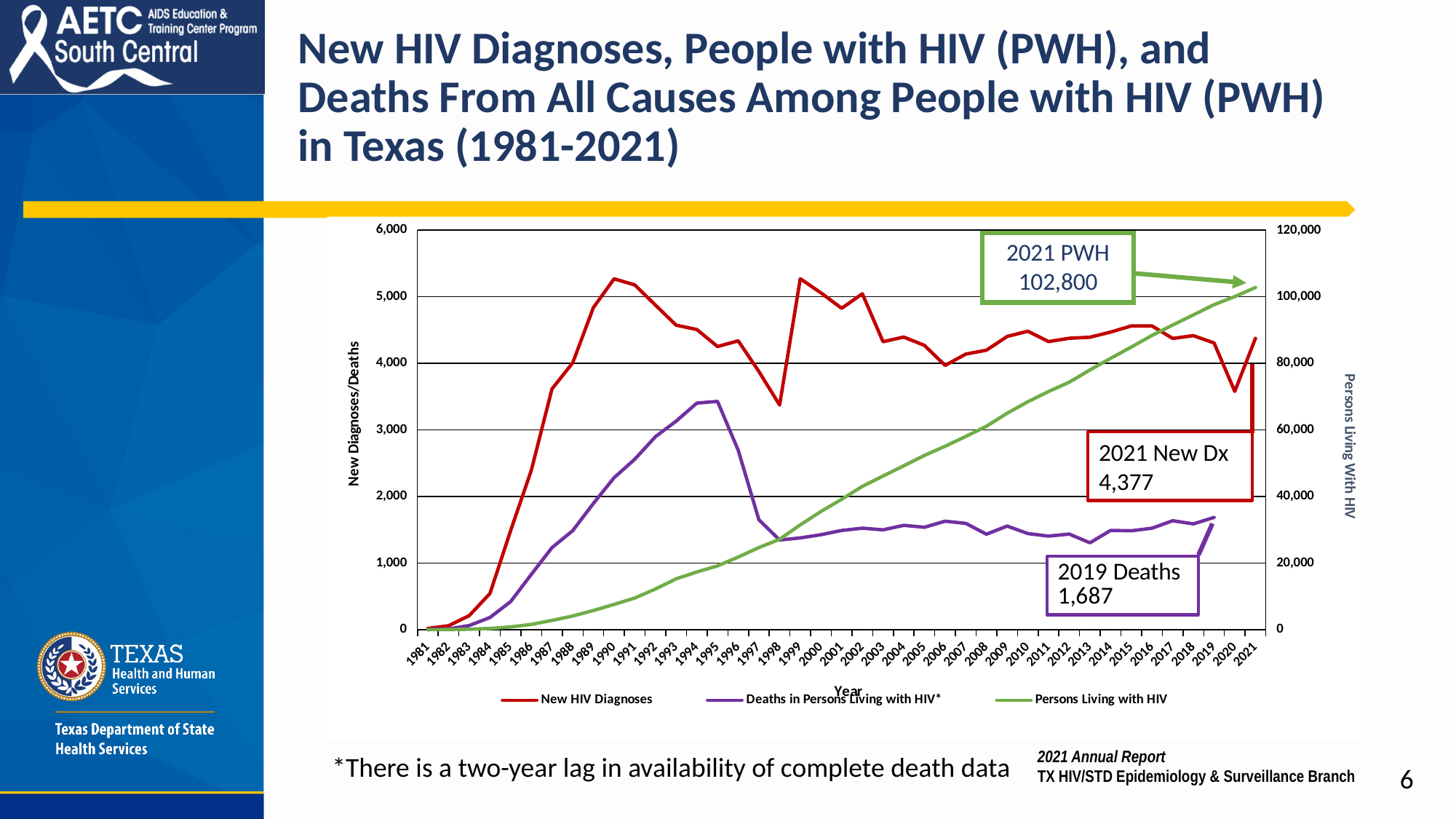
What kind of chart is shown on the slide? line chart Is the value for Deaths in Persons Living with HIV in 1995 greater or less than 3,000? greater What is the number of Persons Living with HIV in 2021? 102,800 How many years are shown on the x axis? 41 Is the value for New HIV Diagnoses in 2020 greater or less than 4,000? less What is the difference between the 2021 New HIV Diagnoses and the 2019 Deaths in Persons Living with HIV? 2,690 What colour is the Persons Living with HIV line? green What is the number of New HIV Diagnoses in 2021? 4,377 How many series does the legend list? 3 Does the Persons Living with HIV line rise or fall from 1981 to 2021? rises Is the value for New HIV Diagnoses in 1990 greater or less than 5,000? greater What is the number of Deaths in Persons Living with HIV in 2019? 1,687